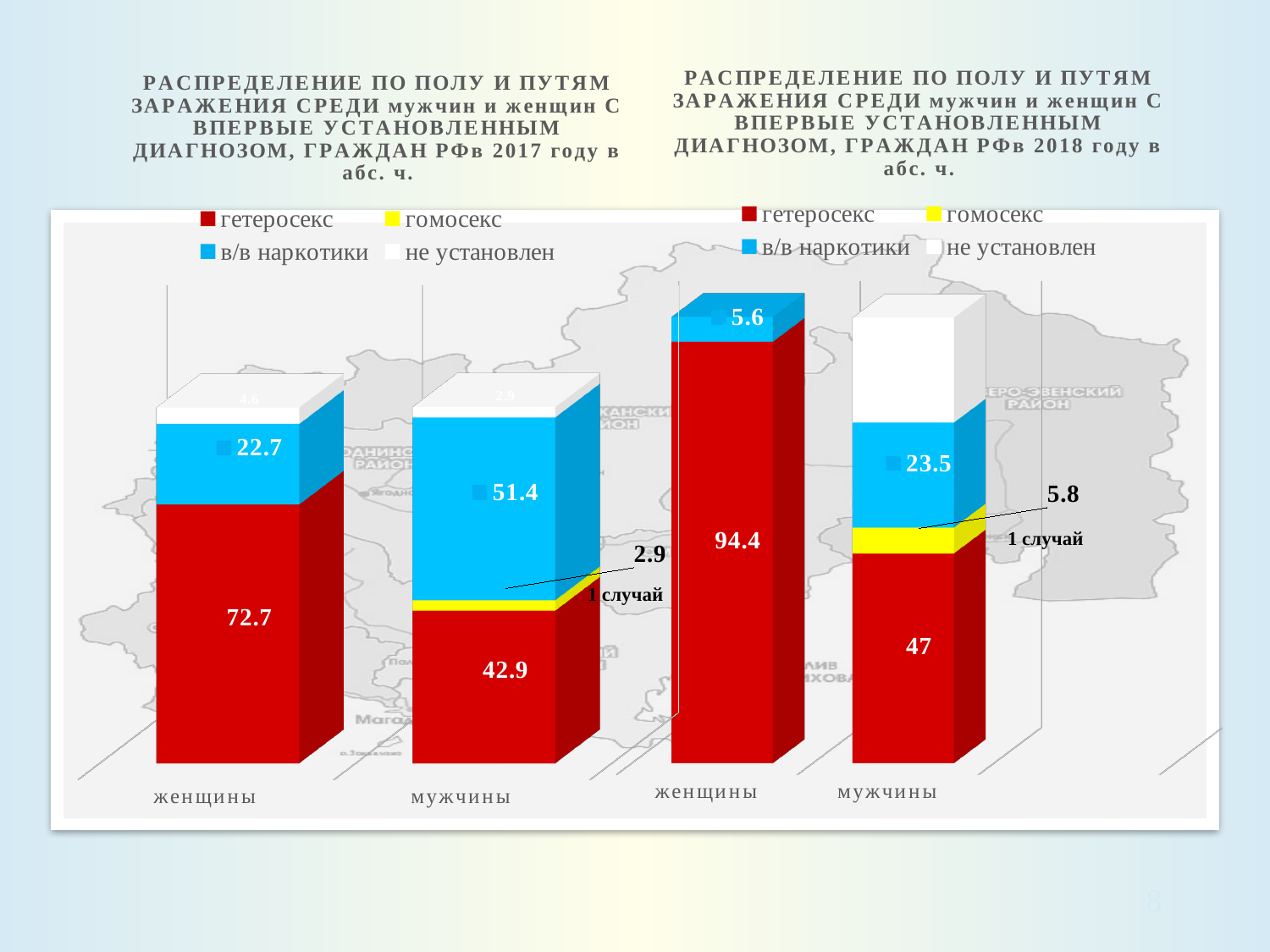
In the 2018 chart, what is the value of в/в наркотики for мужчины? 23.5 How many series does the legend of the 2018 chart list? 4 In the 2017 chart, what is the difference between the гетеросекс values for женщины and мужчины? 29.8 In the 2017 chart, what is the value of в/в наркотики for мужчины? 51.4 In the 2018 chart, what is the value of гетеросекс for женщины? 94.4 How many categories are shown on the x axis of the 2017 chart? 2 In the 2017 chart, what is the value of гетеросекс for женщины? 72.7 In the 2017 chart, what is the value of гетеросекс for мужчины? 42.9 In the 2018 chart, what is the total of the stacked bar for женщины? 100 In the 2018 chart, what is the value of гомосекс for мужчины? 5.8 What kind of chart is the 2018 chart? stacked bar chart In the 2017 chart, which is larger for мужчины: гетеросекс or в/в наркотики? в/в наркотики